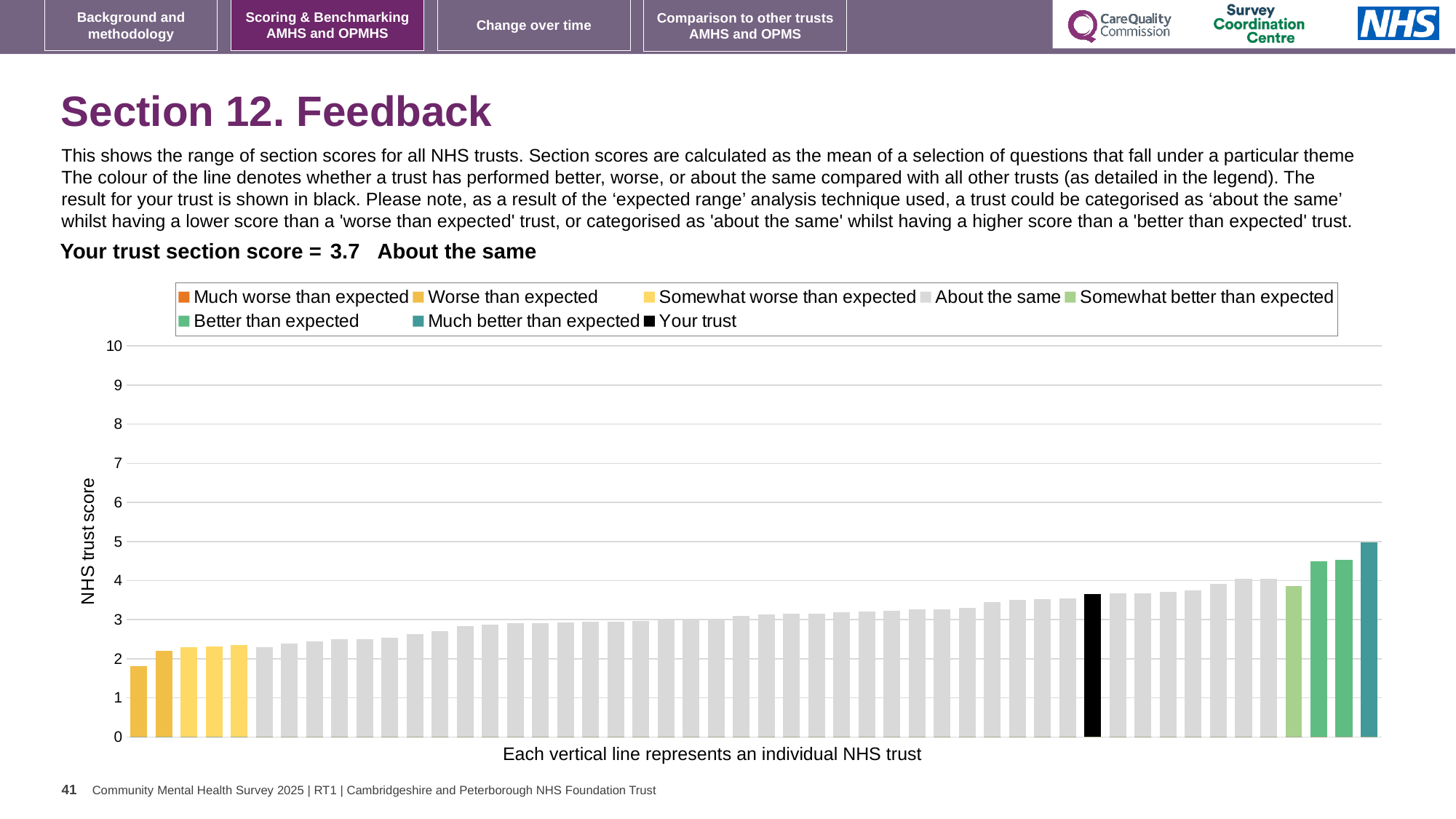
Is the value for Your trust greater or less than 3? greater What kind of chart is shown on the slide? bar chart What is the section score for Your trust? 3.7 Is the value for Your trust greater or less than 4? less How many entries does the chart legend list? 8 Do the bar values rise or fall from left to right along the x axis? rise What is the title of the vertical axis? NHS trust score Which performance category is Your trust placed in for Section 12. Feedback? About the same Which legend category does the tallest bar belong to? Much better than expected Is the value of the leftmost bar greater or less than 2? less Which is larger, the value for Your trust or the value of the leftmost bar? Your trust